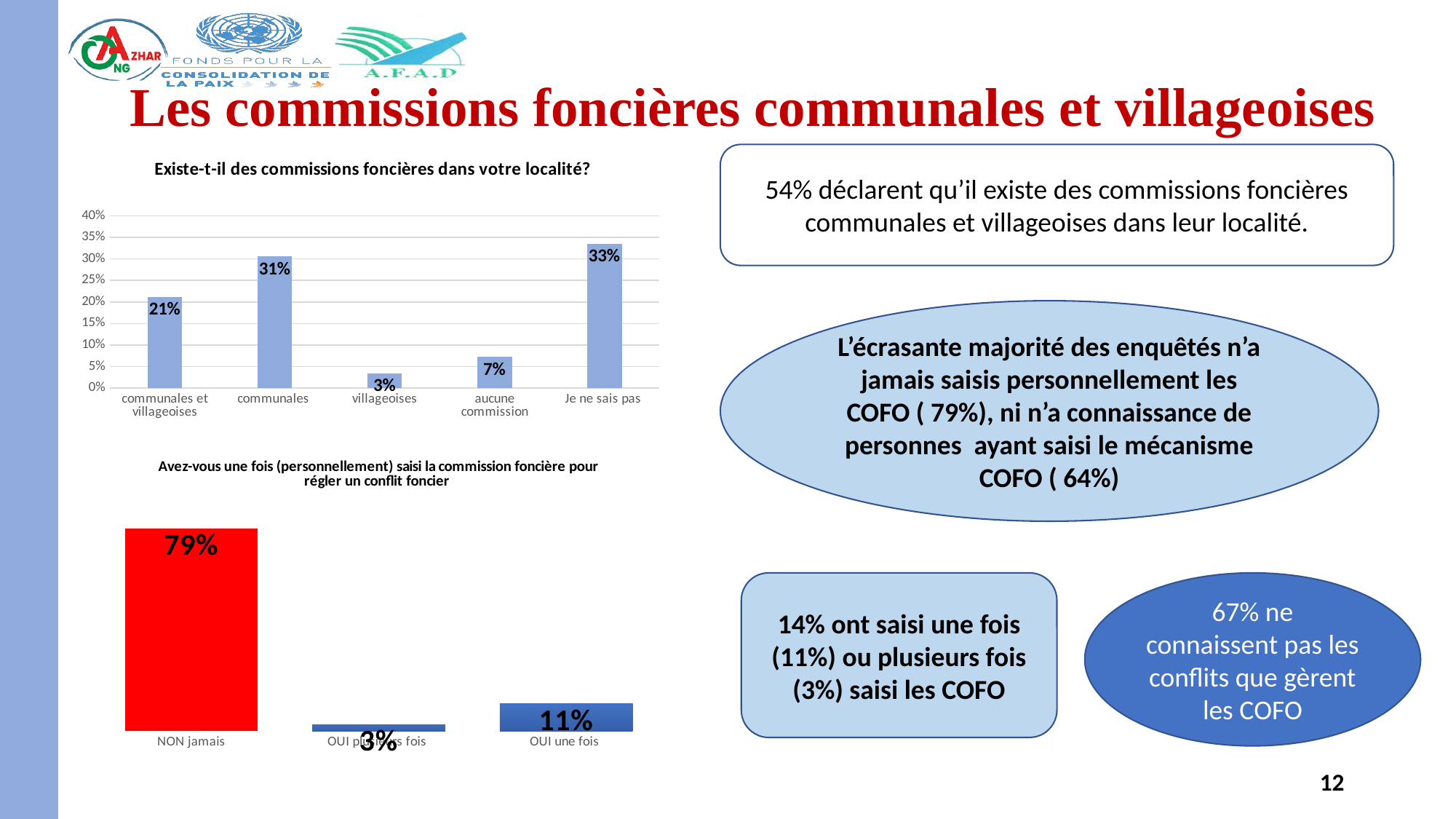
In the chart 'Avez-vous une fois (personnellement) saisi la commission foncière pour régler un conflit foncier', what is the difference between 'NON jamais' and 'OUI une fois'? 68% In the chart 'Existe-t-il des commissions foncières dans votre localité?', which category has the highest value? Je ne sais pas What type of chart is the bottom-left chart on the slide? Bar chart In the chart 'Existe-t-il des commissions foncières dans votre localité?', what is the value for 'aucune commission'? 7% In the chart 'Avez-vous une fois (personnellement) saisi la commission foncière pour régler un conflit foncier', what is the value for 'OUI une fois'? 11% In the chart 'Existe-t-il des commissions foncières dans votre localité?', what is the value for 'communales'? 31% In the chart 'Avez-vous une fois (personnellement) saisi la commission foncière pour régler un conflit foncier', what is the value for 'NON jamais'? 79% In the chart 'Existe-t-il des commissions foncières dans votre localité?', what is the difference between 'communales' and 'communales et villageoises'? 10% In the chart 'Existe-t-il des commissions foncières dans votre localité?', how many categories are shown? 5 In the chart 'Avez-vous une fois (personnellement) saisi la commission foncière pour régler un conflit foncier', which is larger: 'OUI une fois' or 'OUI plusieurs fois'? OUI une fois In the chart 'Existe-t-il des commissions foncières dans votre localité?', which category has the lowest value? villageoises In the chart 'Existe-t-il des commissions foncières dans votre localité?', is the value for 'Je ne sais pas' greater or less than 30%? greater